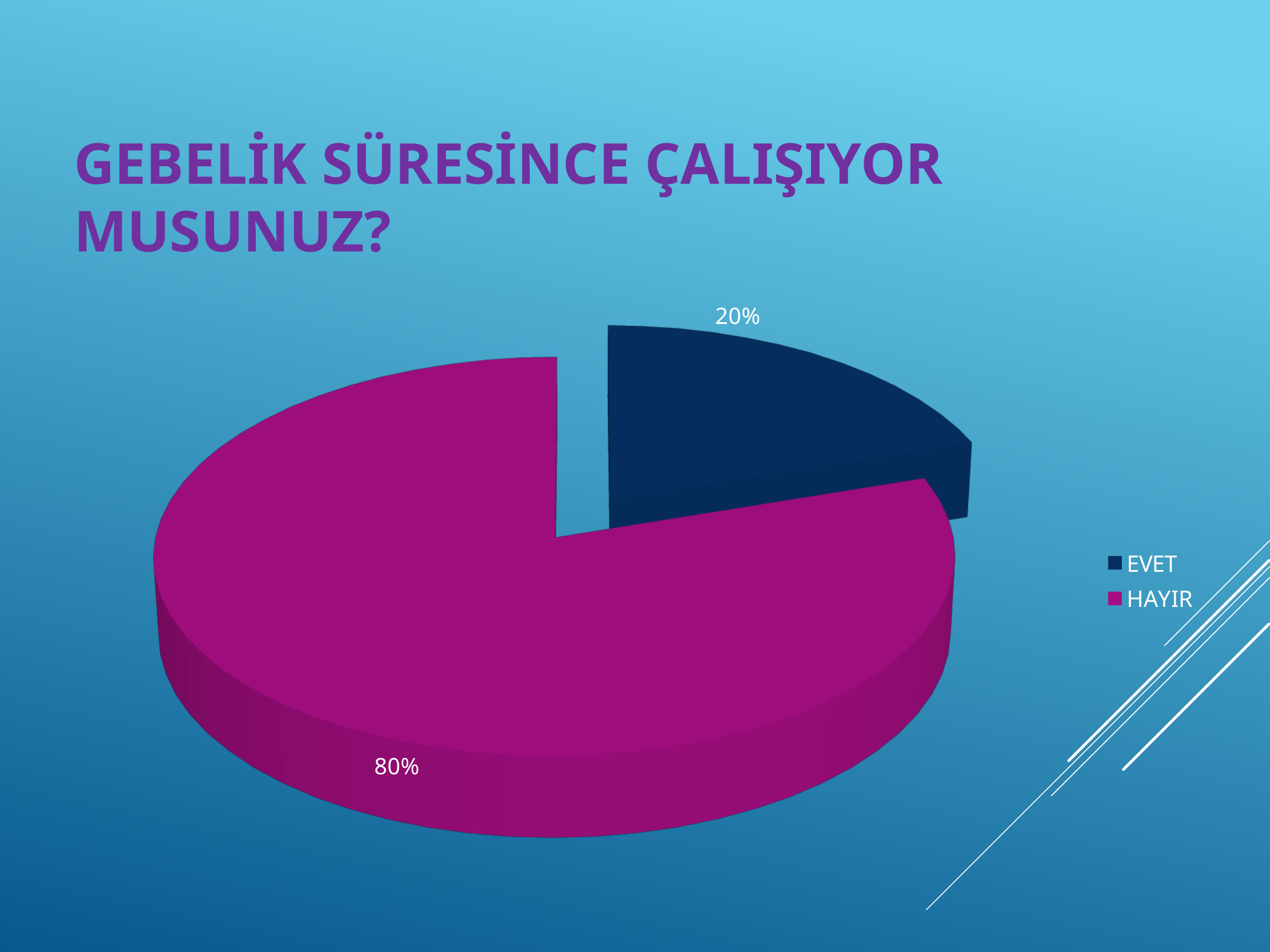
How many entries does the legend list? 2 Which slice is larger, EVET or HAYIR? HAYIR Which category has the largest share of the pie? HAYIR What percentage of the pie is labelled HAYIR? 80% What is the difference in percentage points between the HAYIR and EVET slices? 60 What colour is the HAYIR slice? Magenta What percentage of the pie is labelled EVET? 20% How many slices does the pie chart have? 2 What is the title of the slide? GEBELİK SÜRESİNCE ÇALIŞIYOR MUSUNUZ? Which category has the smallest share of the pie? EVET What kind of chart is shown on the slide? Pie chart What share of the pie does the EVET slice represent? 20%